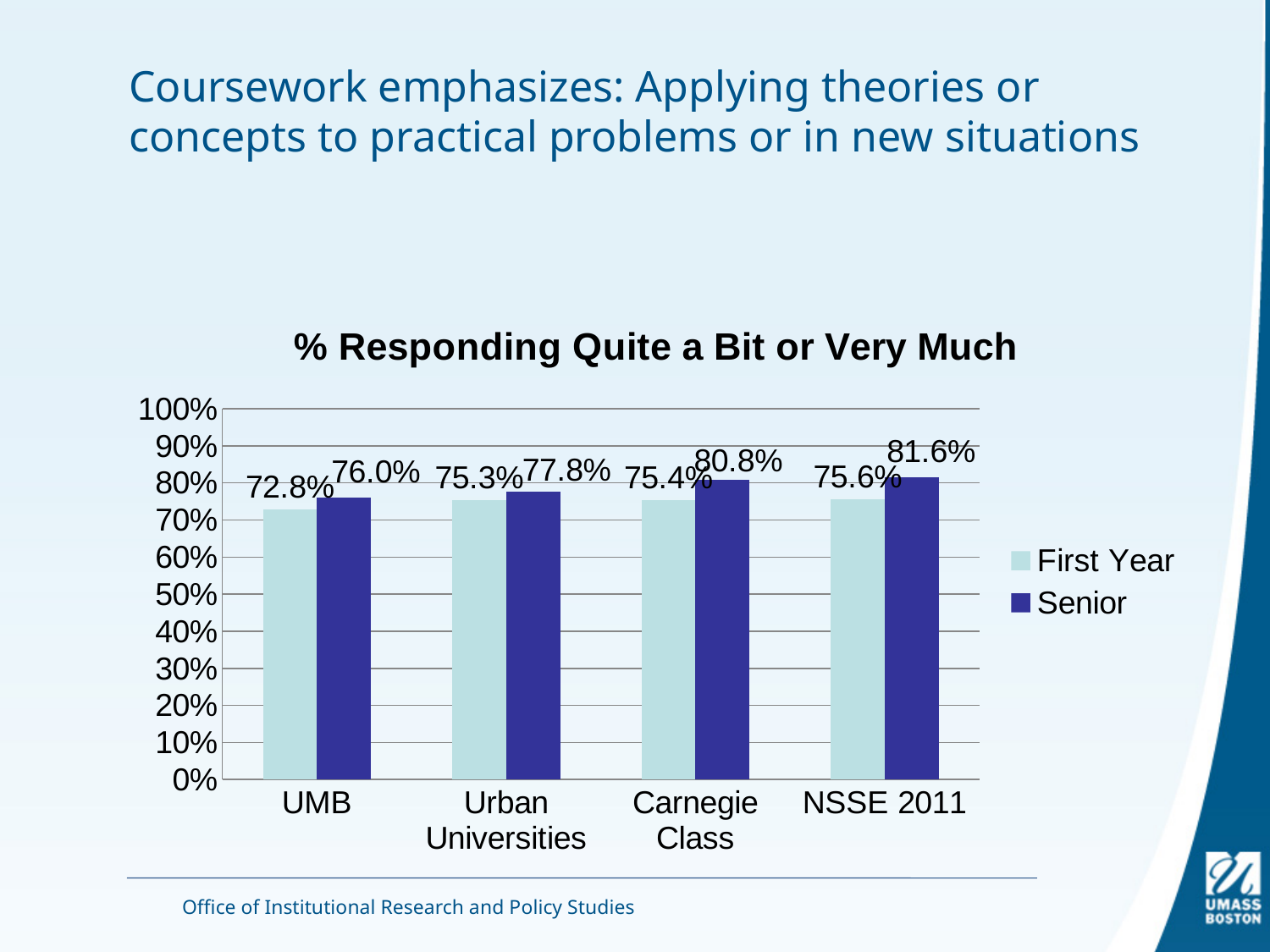
What is the Senior value for Carnegie Class? 80.8% Which category has the highest Senior value? NSSE 2011 Which is larger for Carnegie Class, the First Year value or the Senior value? Senior What is the difference between the Senior and First Year values for UMB? 3.2% How many categories are shown on the x axis? 4 What is the First Year value for Urban Universities? 75.3% Which category has the lowest First Year value? UMB What is the Senior value for NSSE 2011? 81.6% What kind of chart is shown on the slide? Bar chart How many series does the legend list? 2 What is the First Year value for UMB? 72.8% What is the title of the chart? % Responding Quite a Bit or Very Much